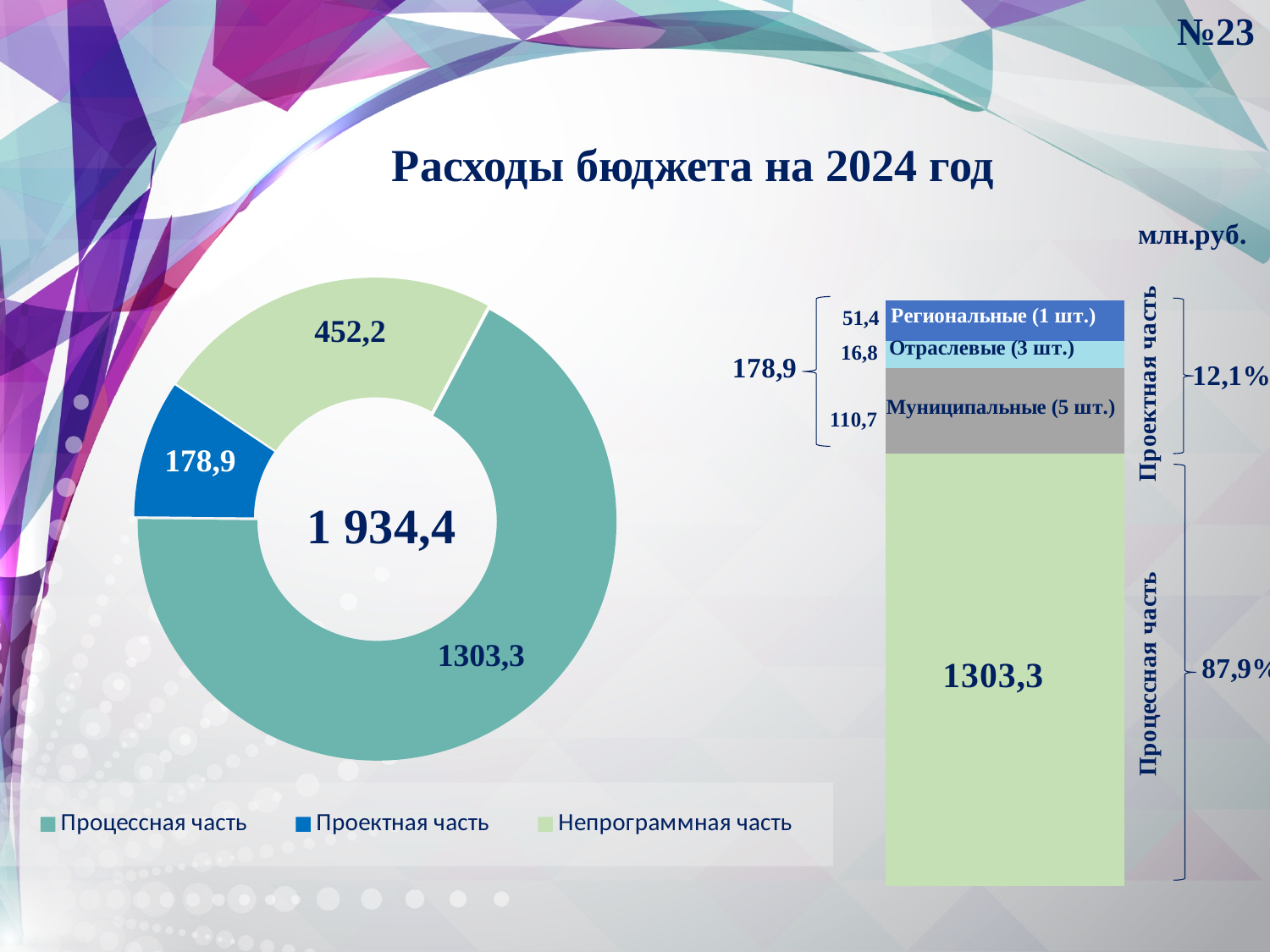
On the donut chart on the left, which category has the smallest value? Проектная часть On the donut chart on the left, what total is shown in the centre? 1 934,4 On the donut chart on the left, which category has the largest value? Процессная часть On the donut chart on the left, what is the value for Непрограммная часть? 452,2 On the stacked bar chart on the right, what percentage is shown for Проектная часть? 12,1% On the donut chart on the left, what is the value for Проектная часть? 178,9 On the donut chart on the left, how many categories does the legend list? 3 On the donut chart on the left, what is the value for Процессная часть? 1303,3 On the stacked bar chart on the right, what is the value for Муниципальные (5 шт.)? 110,7 On the stacked bar chart on the right, which is larger: Отраслевые (3 шт.) or Региональные (1 шт.)? Региональные (1 шт.) On the stacked bar chart on the right, what is the value for Региональные (1 шт.)? 51,4 On the donut chart on the left, what is the difference between Непрограммная часть and Проектная часть? 273,3